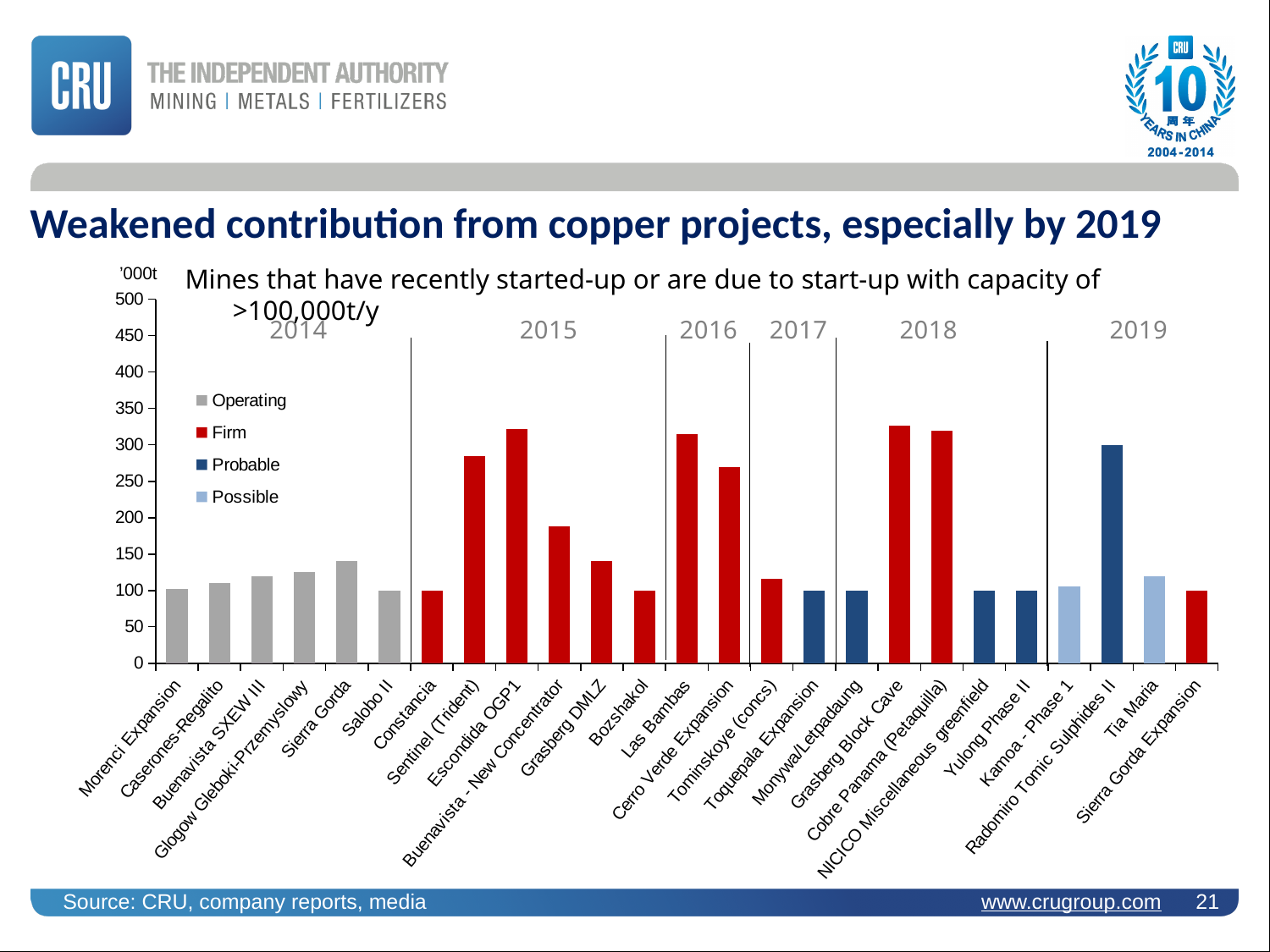
Is the value for Tominskoye (concs) greater or less than 150? less Which is larger, the value for Sentinel (Trident) or the value for Grasberg DMLZ? Sentinel (Trident) How many series does the legend list? 4 Which is larger, the value for Las Bambas or the value for Cerro Verde Expansion? Las Bambas Is the value for Buenavista - New Concentrator greater or less than 200? less Is the value for Sierra Gorda greater or less than 100? greater Which legend series is shown in red? Firm How many mines (categories) are plotted on the x axis? 25 What unit is shown on the y axis of the chart? '000t What kind of chart is shown on the slide? bar chart